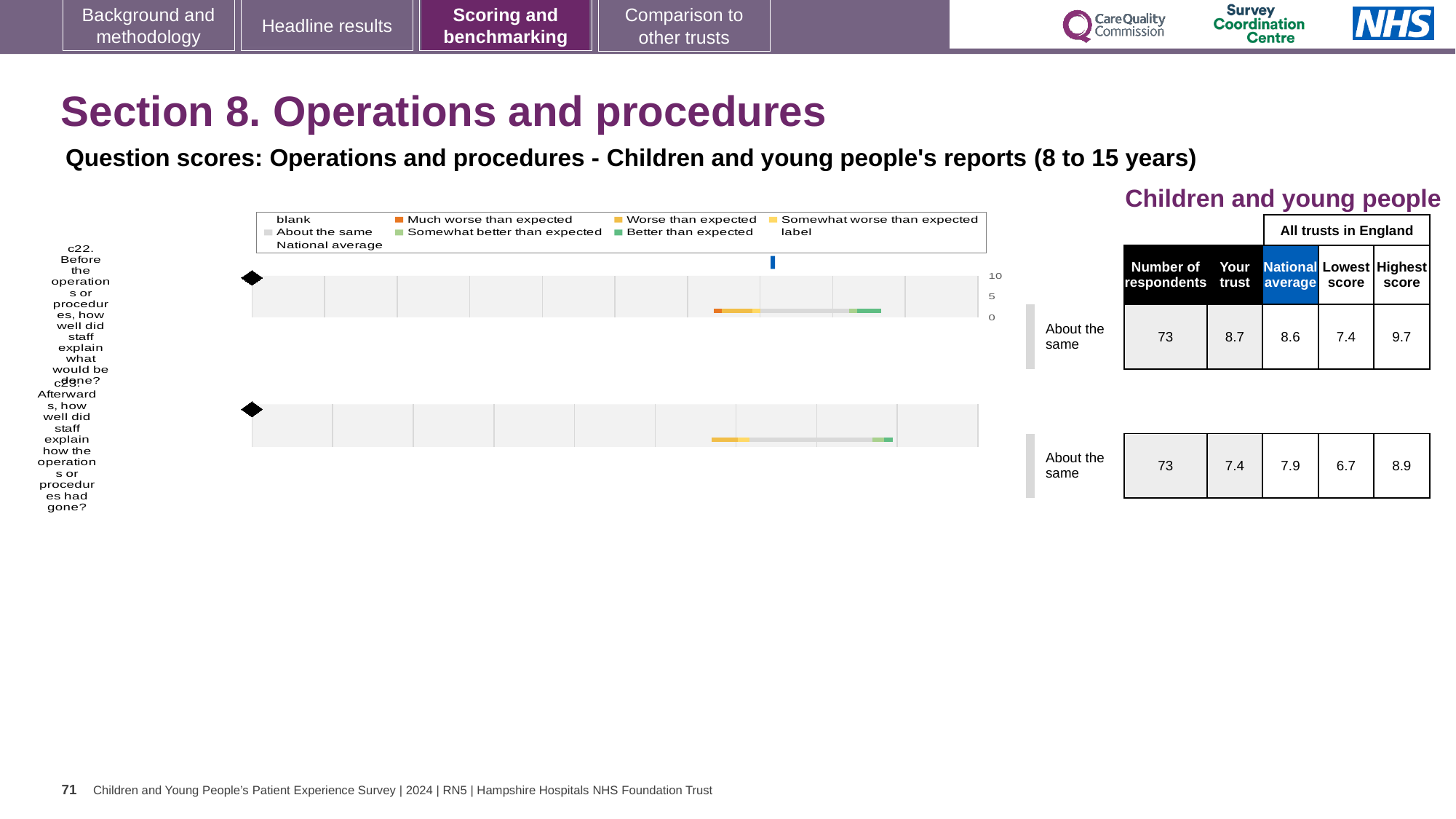
What kind of chart is used to show the question scores for c22 and c23? bar chart What benchmark category is shown next to the c23 bar? About the same What colour does the legend use for 'Much worse than expected'? orange What is the highest score among all trusts in England for c23? 8.9 Which of the two questions has the higher 'Your trust' score? c22 What is the 'Your trust' score for c22 (Before the operations or procedures, how well did staff explain what would be done?)? 8.7 What is the national average score for c23 (Afterwards, how well did staff explain how the operations or procedures had gone?)? 7.9 For c22, which is larger: the 'Your trust' score or the national average? Your trust How many questions (rows) are plotted in the chart? 2 For c23, how much lower is the 'Your trust' score than the national average? 0.5 What is the difference between the highest score and the lowest score for c22? 2.3 How many respondents answered question c22? 73